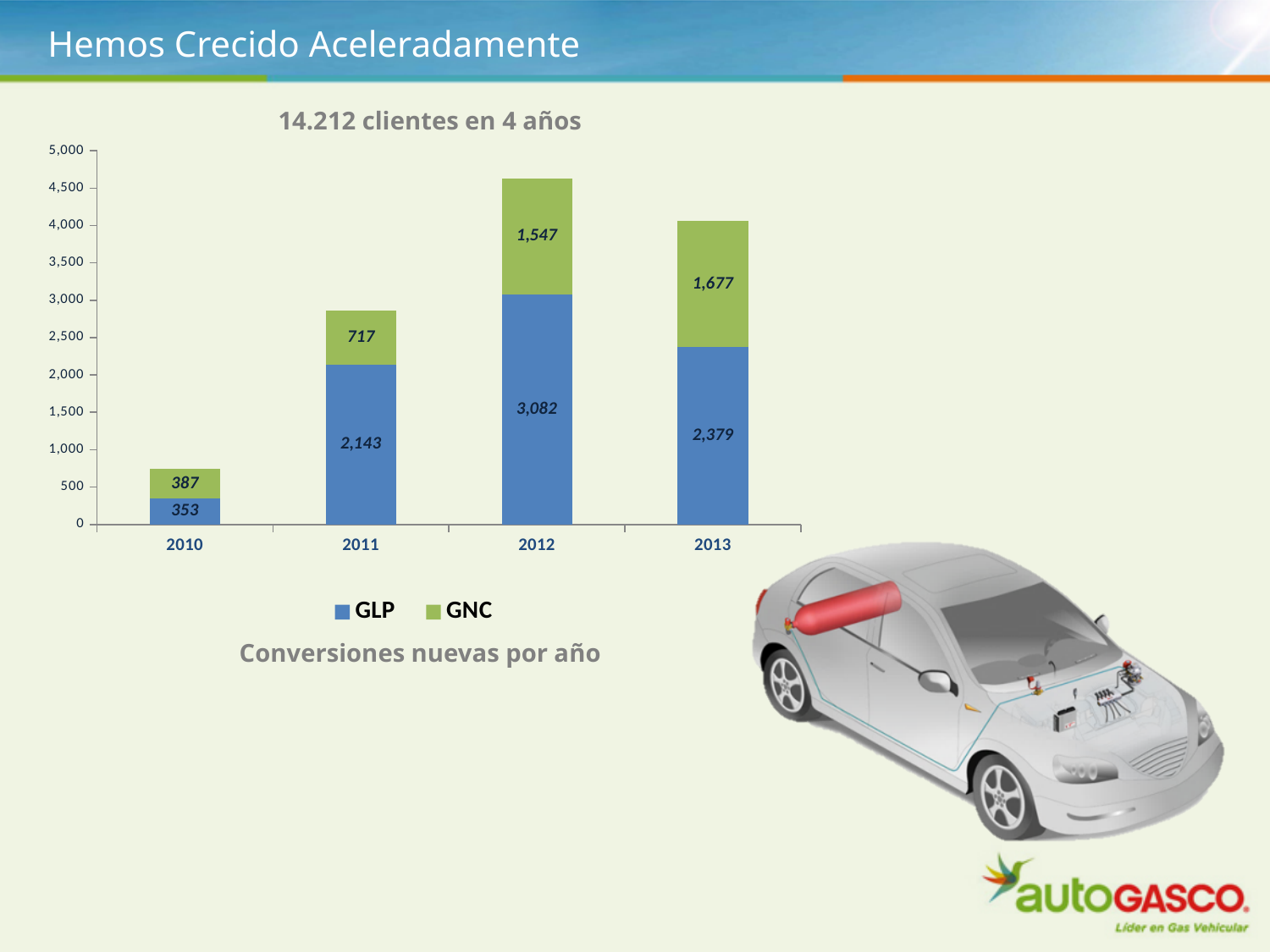
Which year has the lowest GNC value? 2010 What is the total of the stacked bar for 2010? 740 What is the total of the stacked bar for 2012? 4,629 What is the GNC value for 2011? 717 Which year has the highest GLP value? 2012 How many years are shown on the x axis? 4 What kind of chart is shown? Stacked bar chart How many series does the legend list? 2 What is the difference between the GNC values for 2013 and 2012? 130 Which is larger, the GLP value for 2011 or the GLP value for 2013? 2013 What is the GLP value for 2012? 3,082 What is the GLP value for 2010? 353